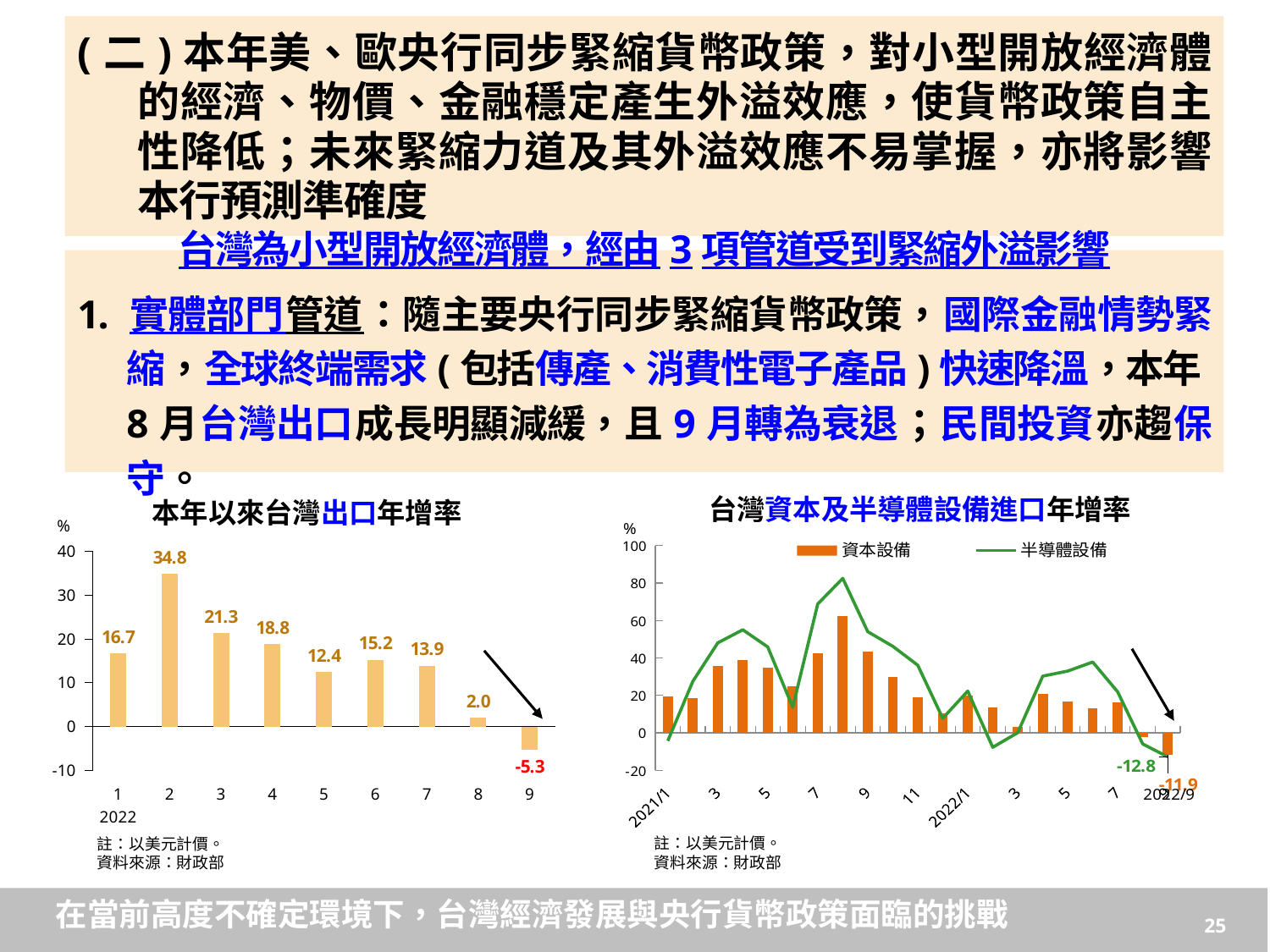
What kind of chart is the one titled 本年以來台灣出口年增率? bar chart In the chart titled 本年以來台灣出口年增率, do the values generally rise or fall from month 2 to month 9? fall In the chart titled 本年以來台灣出口年增率, what is the value for month 2? 34.8 In the chart titled 本年以來台灣出口年增率, how many months are plotted? 9 In the chart titled 本年以來台灣出口年增率, which month has the lowest value? 9 In the chart titled 本年以來台灣出口年增率, what is the value for month 9? -5.3 In the chart titled 台灣資本及半導體設備進口年增率, how many series does the legend list? 2 In the chart titled 本年以來台灣出口年增率, which is larger, the value for month 5 or month 6? month 6 In the chart titled 台灣資本及半導體設備進口年增率, what is the value for 半導體設備 at 2022/9? -12.8 In the chart titled 本年以來台灣出口年增率, which month has the highest value? 2 In the chart titled 本年以來台灣出口年增率, what is the difference between the values for month 2 and month 3? 13.5 In the chart titled 台灣資本及半導體設備進口年增率, what is the value for 資本設備 at 2022/9? -11.9